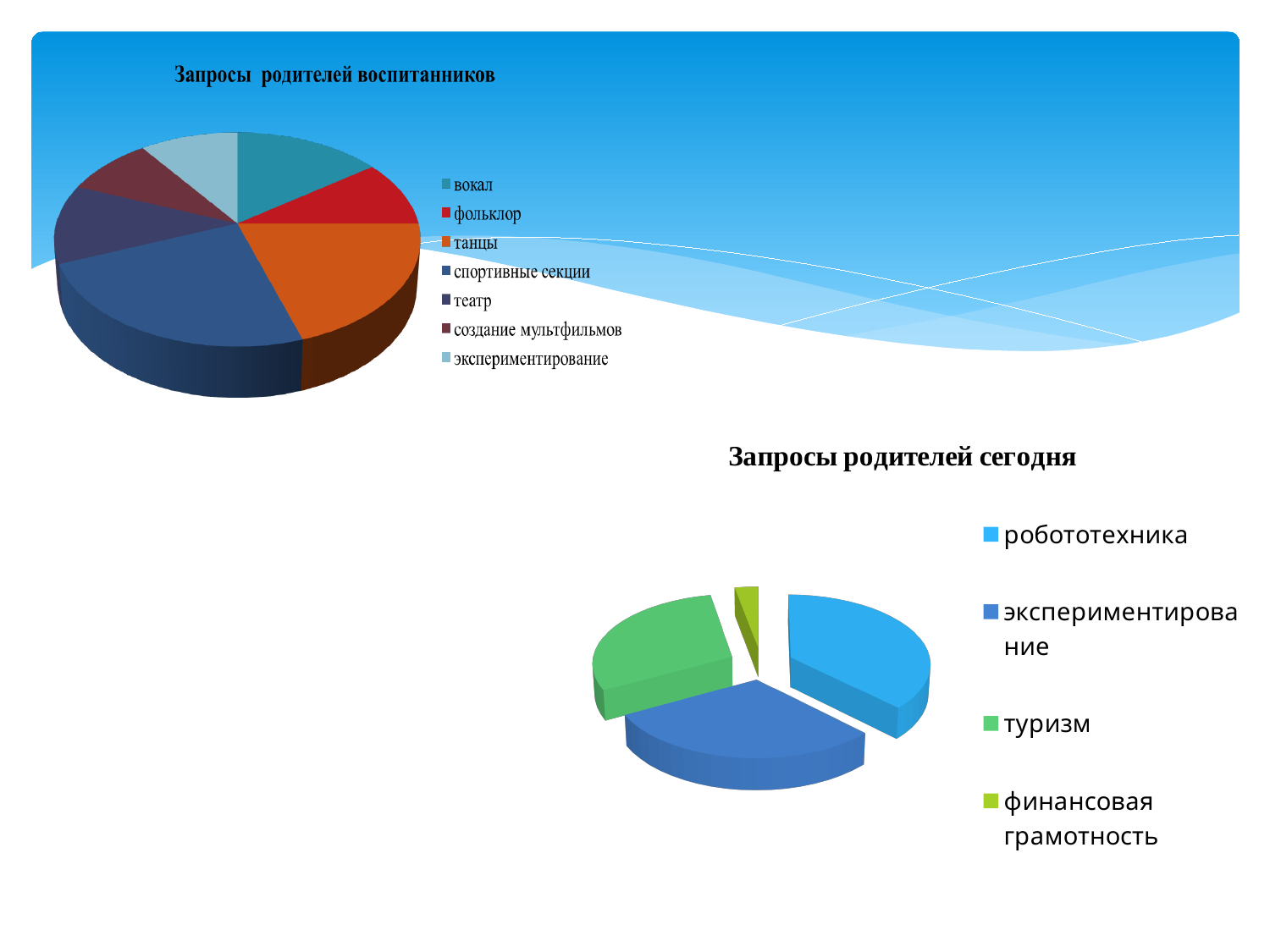
In the chart titled "Запросы родителей сегодня", which category has the smallest slice? финансовая грамотность In the chart titled "Запросы родителей воспитанников", which slice is larger: спортивные секции or вокал? спортивные секции In the chart titled "Запросы родителей сегодня", which slice is larger: туризм or финансовая грамотность? туризм What kind of chart is the chart titled "Запросы родителей сегодня"? pie chart What is the title of the pie chart in the lower right of the slide? Запросы родителей сегодня In the chart titled "Запросы родителей сегодня", which category is shown in green? туризм In the chart titled "Запросы родителей воспитанников", which category has the largest slice? спортивные секции In the chart titled "Запросы родителей воспитанников", how many categories does the legend list? 7 In the chart titled "Запросы родителей сегодня", which category has the largest slice? робототехника What kind of chart is the chart titled "Запросы родителей воспитанников"? pie chart In the chart titled "Запросы родителей сегодня", how many slices does the pie have? 4